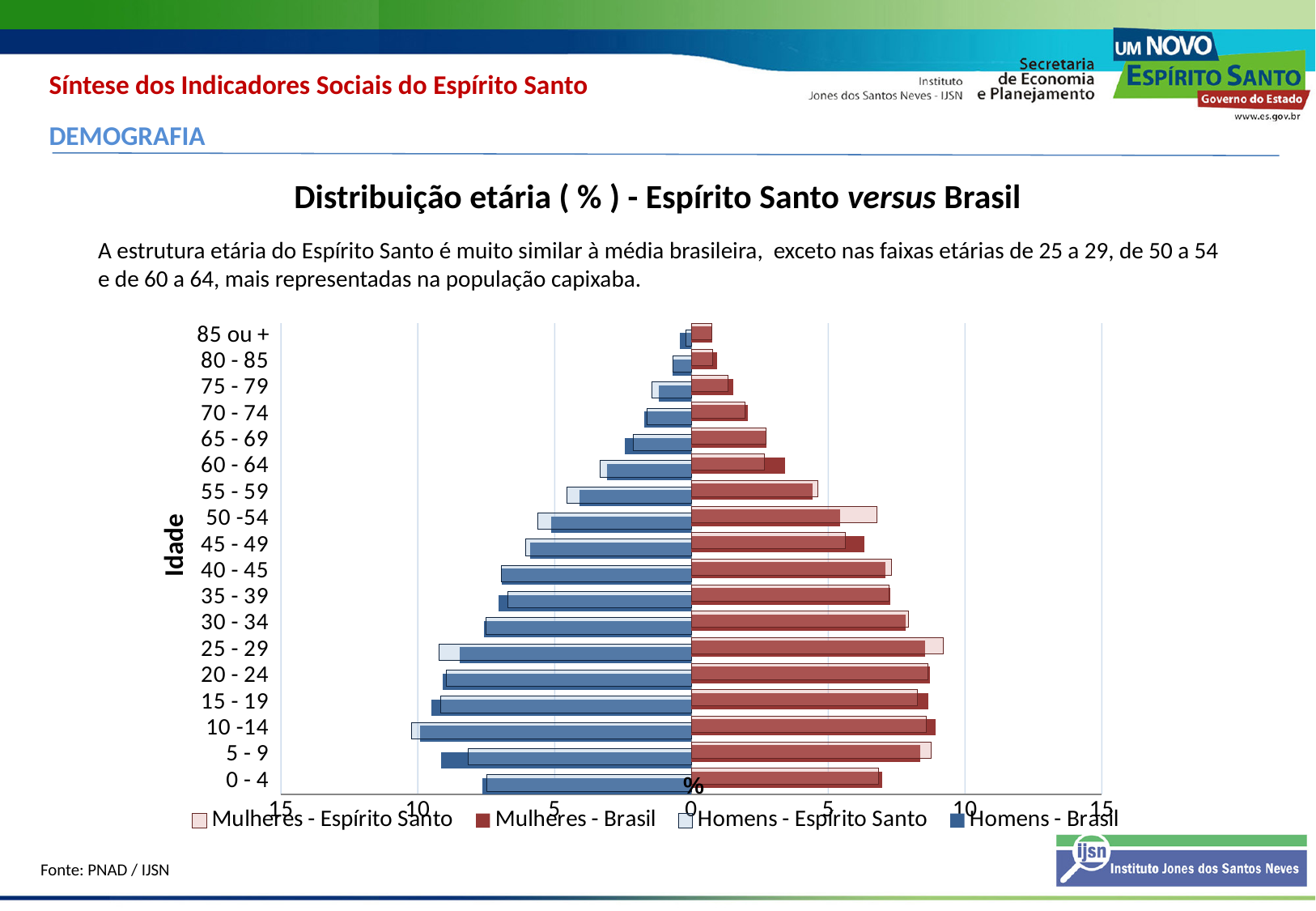
Which series is shown in dark blue according to the legend? Homens - Brasil Is the value for Homens - Brasil in the 60 - 64 age group greater or less than 5? less How many age groups are shown on the vertical axis? 18 What kind of chart is shown on the slide? bar chart How many series does the legend list? 4 Which age group has the longest bar for Homens - Brasil? 10 -14 What is the title of the chart? Distribuição etária ( % ) - Espírito Santo versus Brasil Which age group has the shortest bar for Homens - Brasil? 85 ou + Is the value for Mulheres - Brasil in the 0 - 4 age group greater or less than 5? greater Which age group has the shortest bar for Mulheres - Brasil? 85 ou + Which is larger for Mulheres - Brasil: the 30 - 34 age group or the 65 - 69 age group? 30 - 34